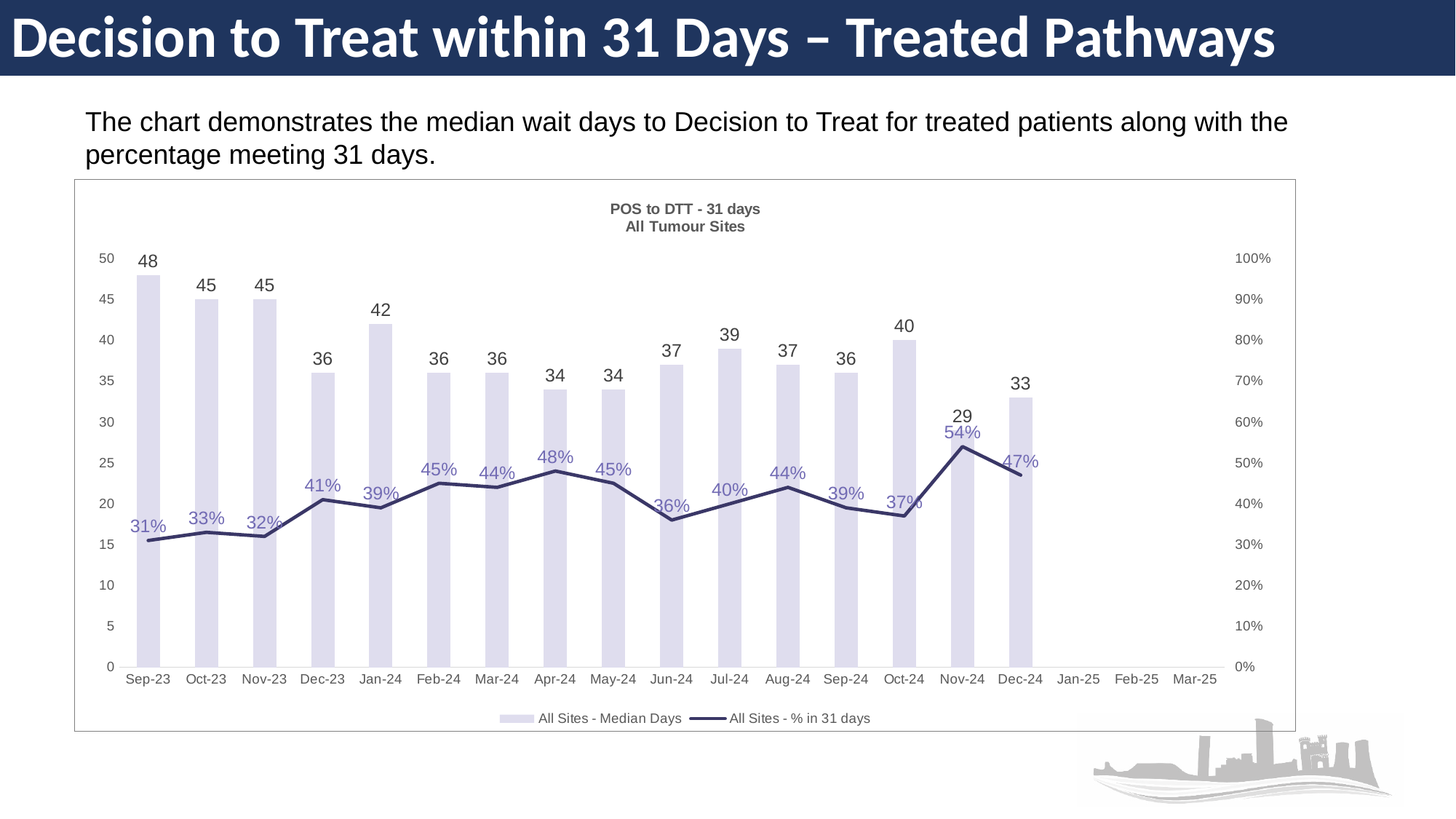
Which series is shown as a line rather than bars? All Sites - % in 31 days Which is larger, the median days for Jan-24 or for Oct-24? Jan-24 What is the title of the chart? POS to DTT - 31 days All Tumour Sites Which month has the lowest All Sites - Median Days value? Nov-24 Which month has the highest All Sites - % in 31 days value? Nov-24 What is the median days value for Dec-24? 33 What is the difference in median days between Sep-23 and Dec-24? 15 How many series does the legend list? 2 Which month has the lowest All Sites - % in 31 days value? Sep-23 How many months have a median days bar plotted? 16 What is the value of All Sites - Median Days for Sep-23? 48 What is the All Sites - % in 31 days value for Nov-24? 54%